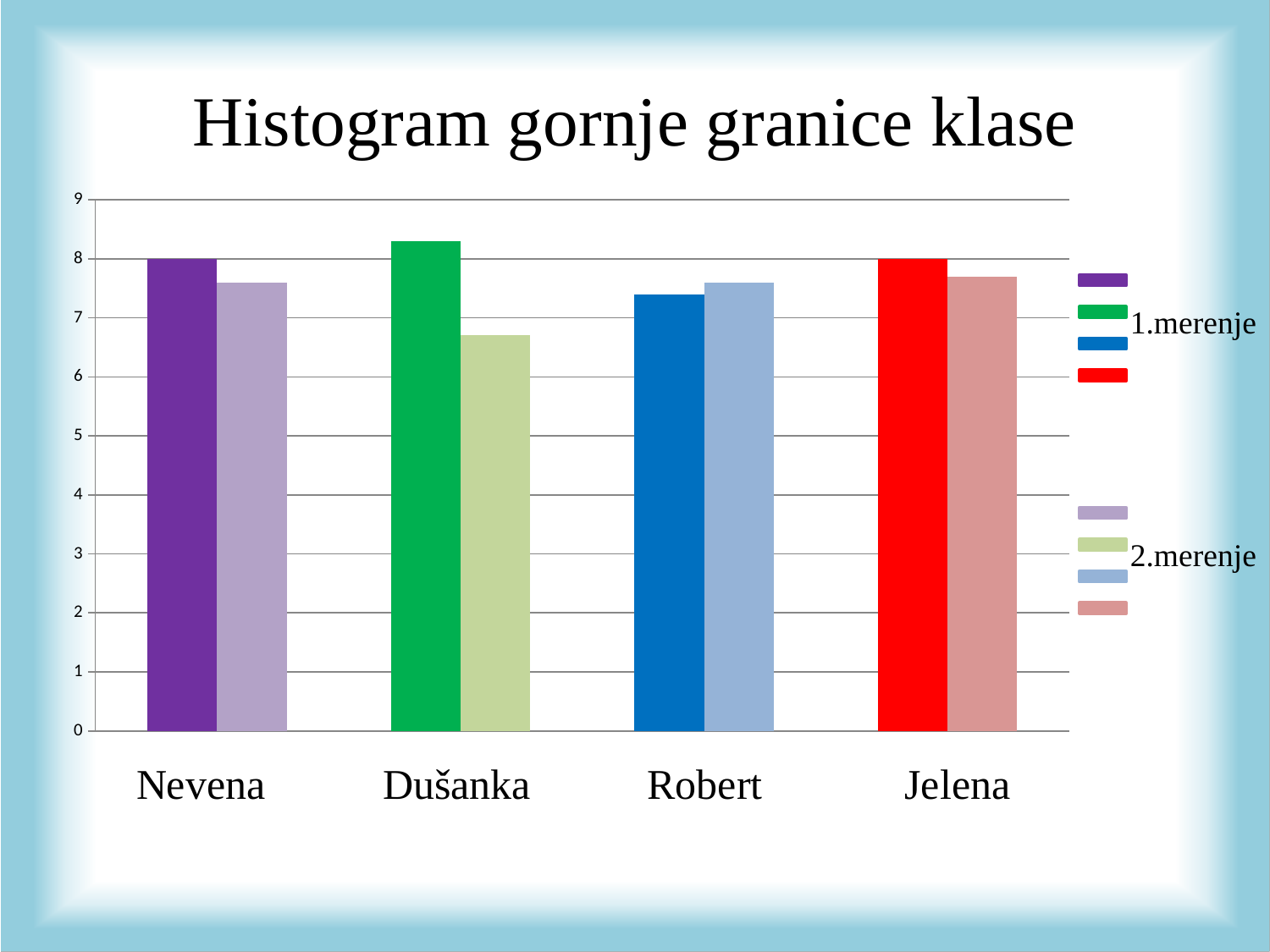
Is the 1.merenje value for Dušanka greater or less than 8? greater Which category has the lowest value for 2.merenje? Dušanka Which category has the highest value for 1.merenje? Dušanka What kind of chart is shown on the slide? bar chart Which category has the lowest value for 1.merenje? Robert What are the two series named in the legend? 1.merenje and 2.merenje For Dušanka, which is larger: the 1.merenje value or the 2.merenje value? 1.merenje How many series does the legend list? 2 How many categories are shown on the x axis of the chart? 4 Is the 1.merenje value for Robert greater or less than 8? less What is the title of the chart? Histogram gornje granice klase Is the 2.merenje value for Dušanka greater or less than 7? less